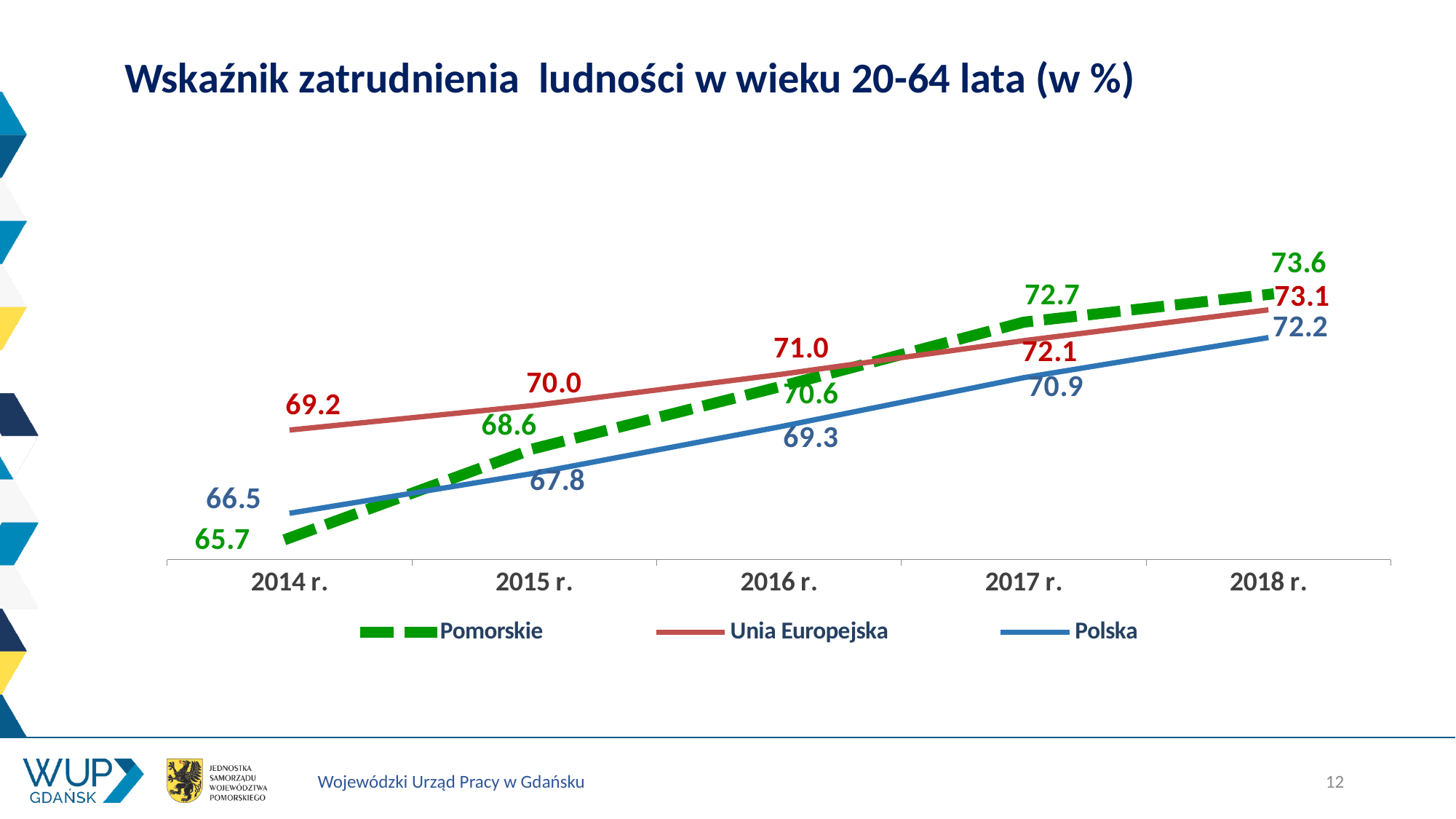
Which series is drawn with a dashed green line? Pomorskie What is the difference between the Pomorskie value and the Polska value in 2018 r.? 1.4 What is the value for Unia Europejska in 2014 r.? 69.2 Which is larger in 2014 r., the value for Pomorskie or the value for Unia Europejska? Unia Europejska How many years are shown on the x axis? 5 In which year is the value for Pomorskie lowest? 2014 r. What is the value for Polska in 2016 r.? 69.3 What is the value for Pomorskie in 2018 r.? 73.6 What type of chart is shown on the slide? line chart Does the value for Unia Europejska rise or fall from 2014 r. to 2018 r.? rise In which year is the value for Polska highest? 2018 r. How many series does the legend list? 3